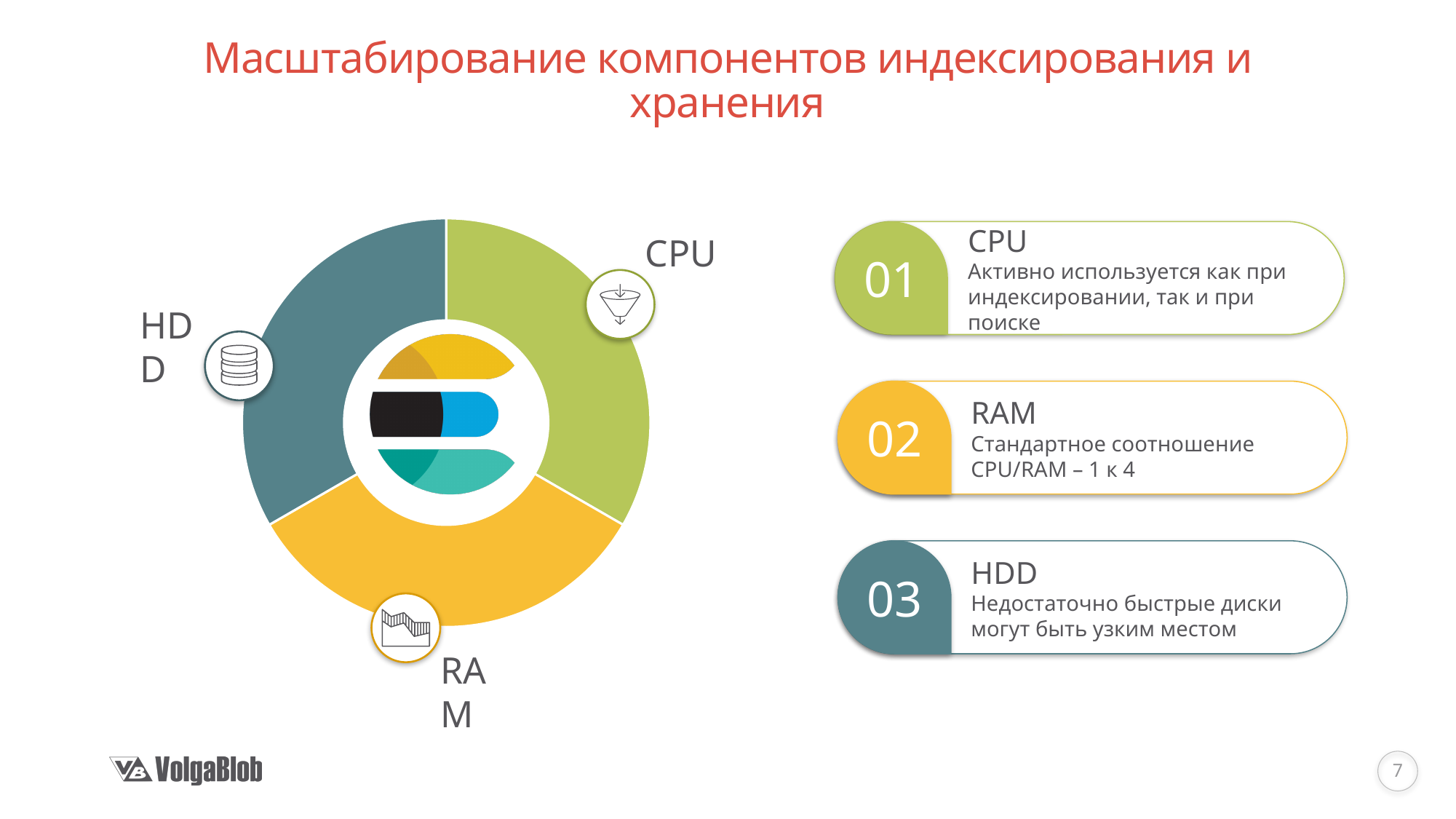
Which segment of the donut chart is coloured yellow/orange? RAM What kind of chart is shown on the left of the slide? Donut (pie) chart Are the three segments of the donut chart roughly equal in size? Yes Which component is labelled at the bottom of the donut chart? RAM What colour is the CPU segment of the donut chart? Green Which segment of the donut chart is coloured dark teal/grey-blue? HDD How many segments does the donut chart have? 3 Which component is labelled on the left side of the donut chart? HDD Which three components are labelled on the donut chart? CPU, RAM, HDD Which component is labelled at the top right of the donut chart? CPU